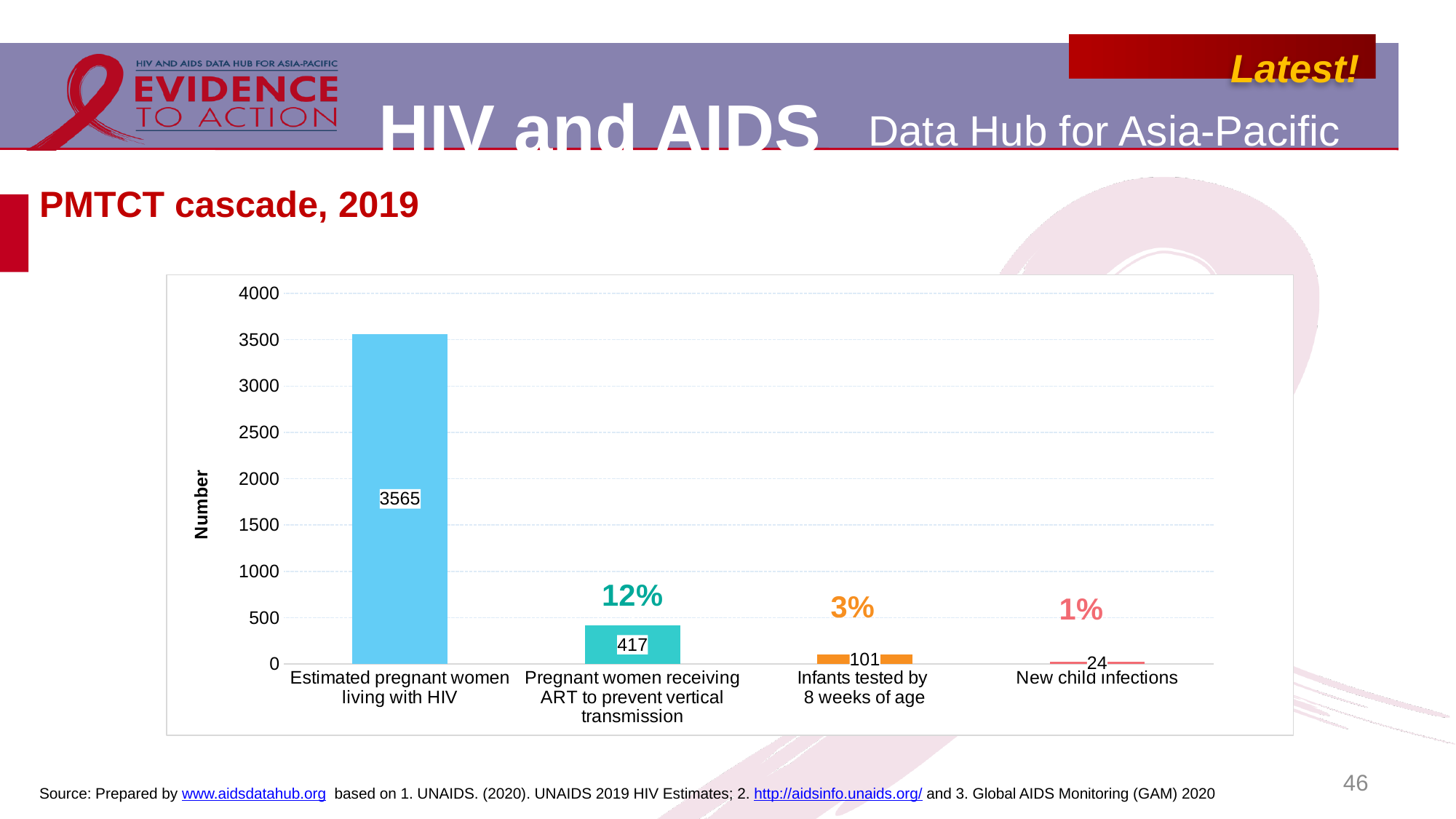
How many categories are shown on the x axis? 4 What is the value for Estimated pregnant women living with HIV? 3565 What kind of chart is shown? bar chart What is the difference between Estimated pregnant women living with HIV and Pregnant women receiving ART to prevent vertical transmission? 3148 What is the value for Infants tested by 8 weeks of age? 101 What is the value for Pregnant women receiving ART to prevent vertical transmission? 417 What is the value for New child infections? 24 Which category has the highest value? Estimated pregnant women living with HIV Which category has the lowest value? New child infections Which is larger: Infants tested by 8 weeks of age or New child infections? Infants tested by 8 weeks of age Is the value for Pregnant women receiving ART to prevent vertical transmission greater or less than 500? less What percentage label is shown above the Infants tested by 8 weeks of age bar? 3%